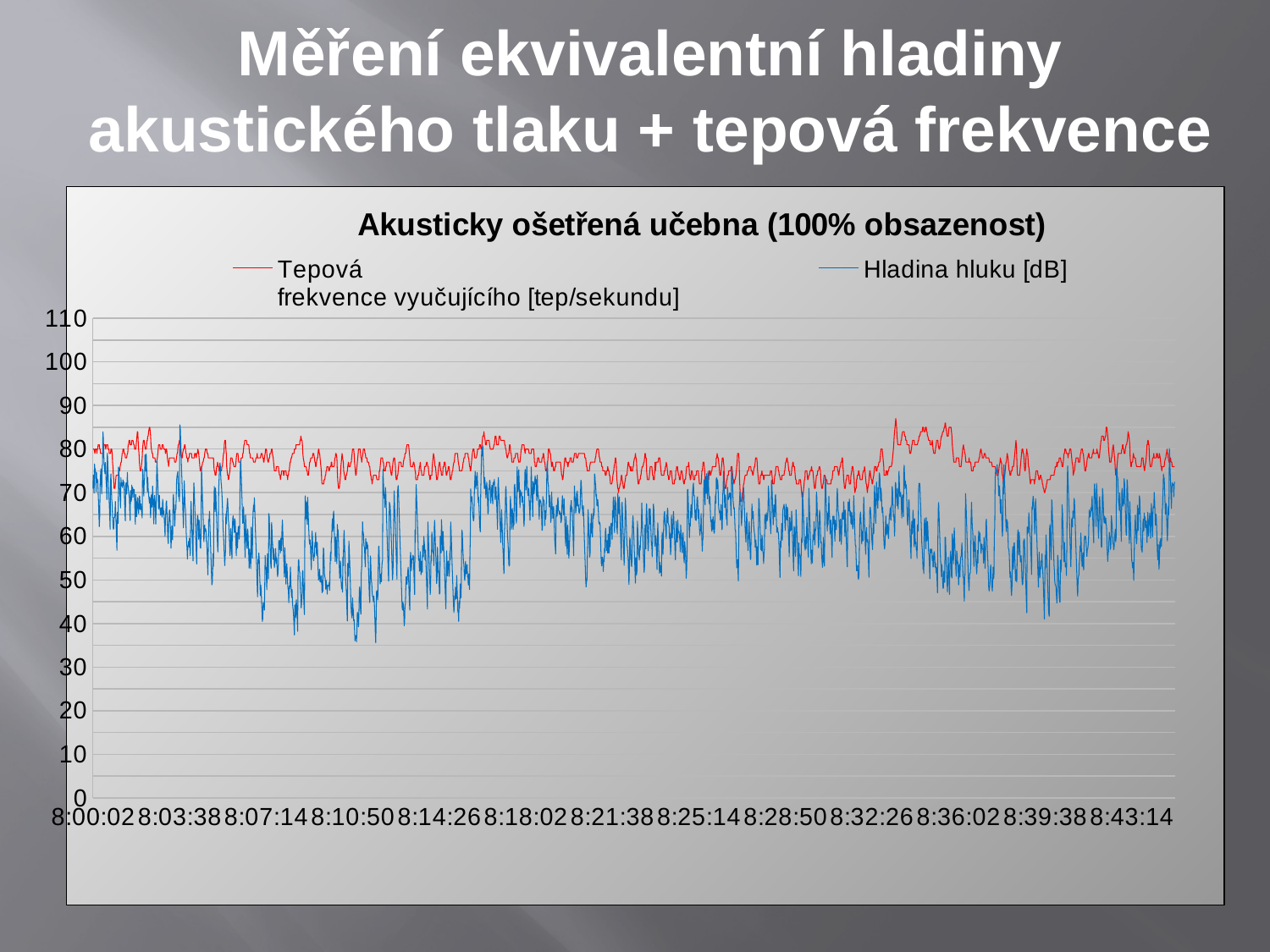
Is the value of 'Tepová frekvence vyučujícího [tep/sekundu]' at 8:00:02 greater or less than 60? greater What is the highest value shown on the y axis? 110 Is the highest value reached by 'Tepová frekvence vyučujícího [tep/sekundu]' greater or less than 100? less Is the lowest value reached by 'Hladina hluku [dB]' greater or less than 50? less Which colour is used for the series 'Hladina hluku [dB]'? blue What is the title of the chart? Akusticky ošetřená učebna (100% obsazenost) Which series is generally higher across the chart, 'Tepová frekvence vyučujícího [tep/sekundu]' or 'Hladina hluku [dB]'? Tepová frekvence vyučujícího [tep/sekundu] How many series does the legend list? 2 How many time labels are shown on the x axis? 13 What kind of chart is shown on the slide? line chart